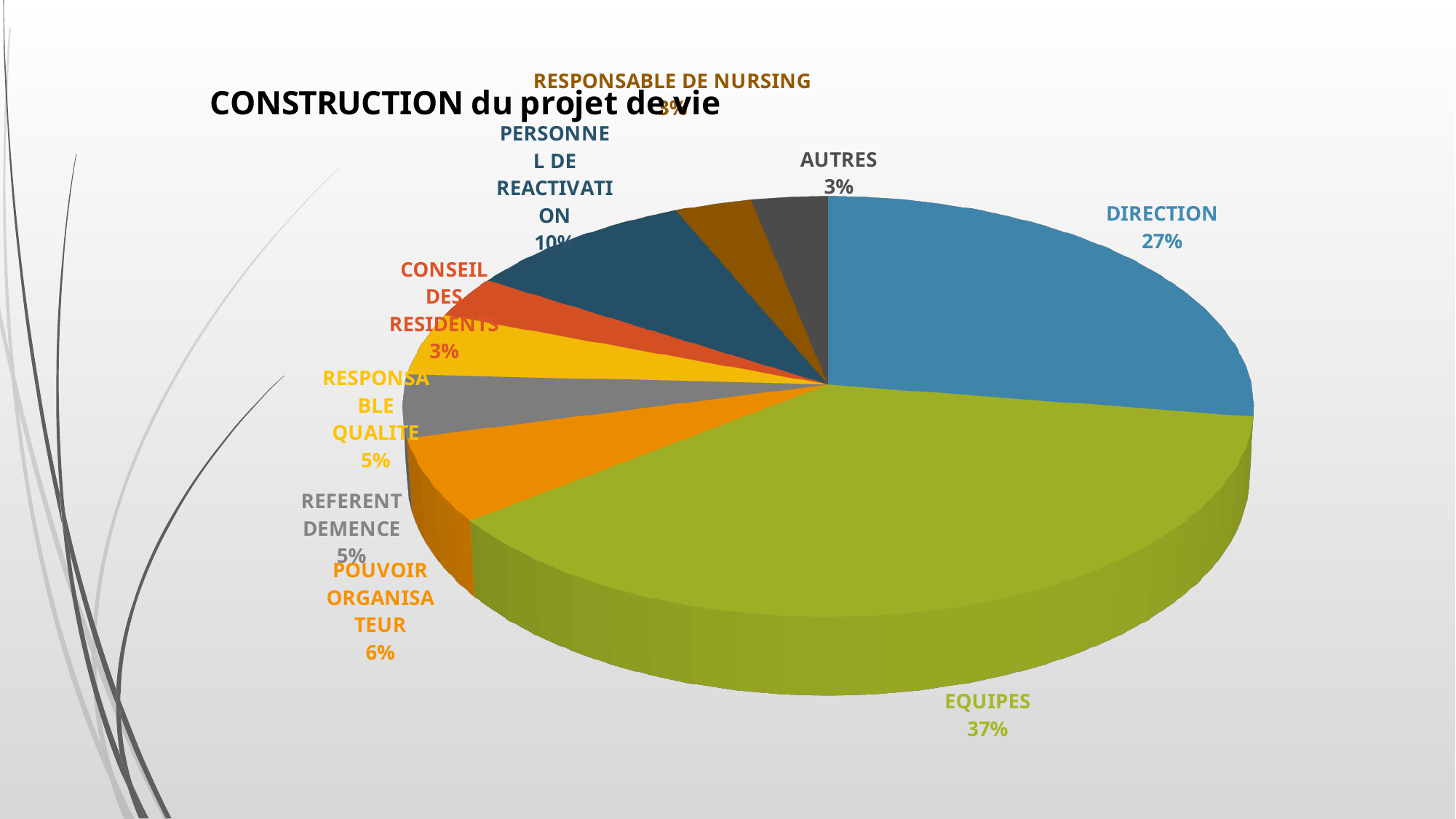
Which category has the largest slice of the pie? EQUIPES What is the difference in percentage points between EQUIPES and DIRECTION? 10 Which is larger, the share for PERSONNEL DE REACTIVATION or the share for RESPONSABLE QUALITE? PERSONNEL DE REACTIVATION What share of the pie does EQUIPES represent? 37% What percentage is shown for REFERENT DEMENCE? 5% What percentage is shown for PERSONNEL DE REACTIVATION? 10% What type of chart is shown on the slide? Pie chart What share of the pie does DIRECTION represent? 27% What percentage is shown for CONSEIL DES RESIDENTS? 3% How many slices does the pie chart have? 9 What is the title of the chart? CONSTRUCTION du projet de vie What percentage is shown for POUVOIR ORGANISATEUR? 6%